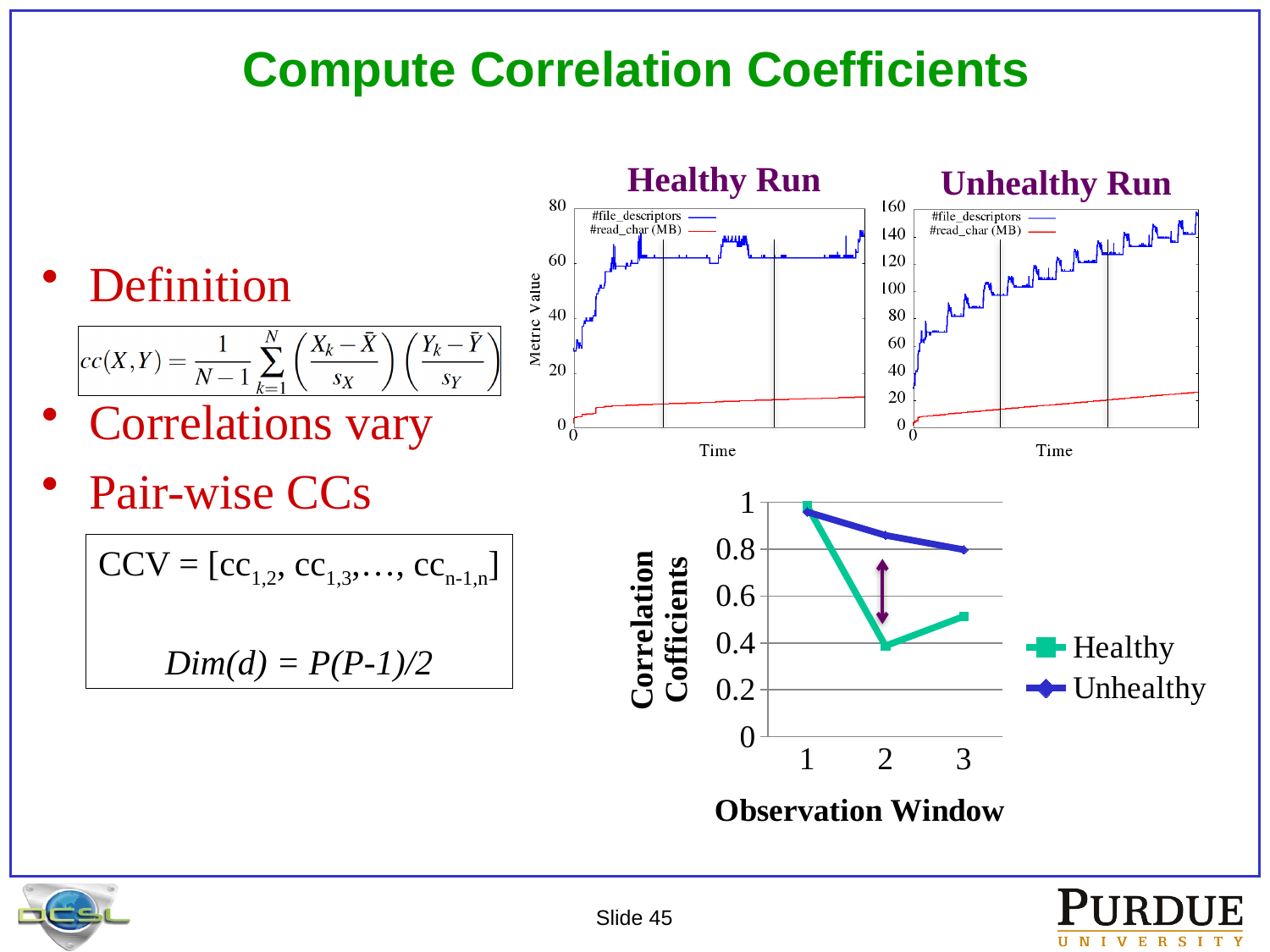
In the Correlation Coefficients chart, is the Healthy value at observation window 3 greater or less than 0.6? less In the Correlation Coefficients chart, at which observation window is the Healthy series lowest? 2 How many series does the legend of the Correlation Coefficients chart list? 2 In the Correlation Coefficients chart, is the Unhealthy value at observation window 2 greater or less than 0.8? greater In the Correlation Coefficients chart, which series has the larger value at observation window 2, Healthy or Unhealthy? Unhealthy In the Unhealthy Run chart, which series is higher, #file_descriptors or #read_char (MB)? #file_descriptors How many observation windows are plotted on the x axis of the Correlation Coefficients chart? 3 In the Correlation Coefficients chart, does the Unhealthy series rise or fall from observation window 1 to 3? fall What kind of chart is the bottom chart with the x axis labelled Observation Window? line chart In the Correlation Coefficients chart, is the Healthy value at observation window 2 greater or less than 0.6? less What are the two series named in the legend of the Correlation Coefficients chart? Healthy and Unhealthy What is the x axis label of the Healthy Run chart? Time